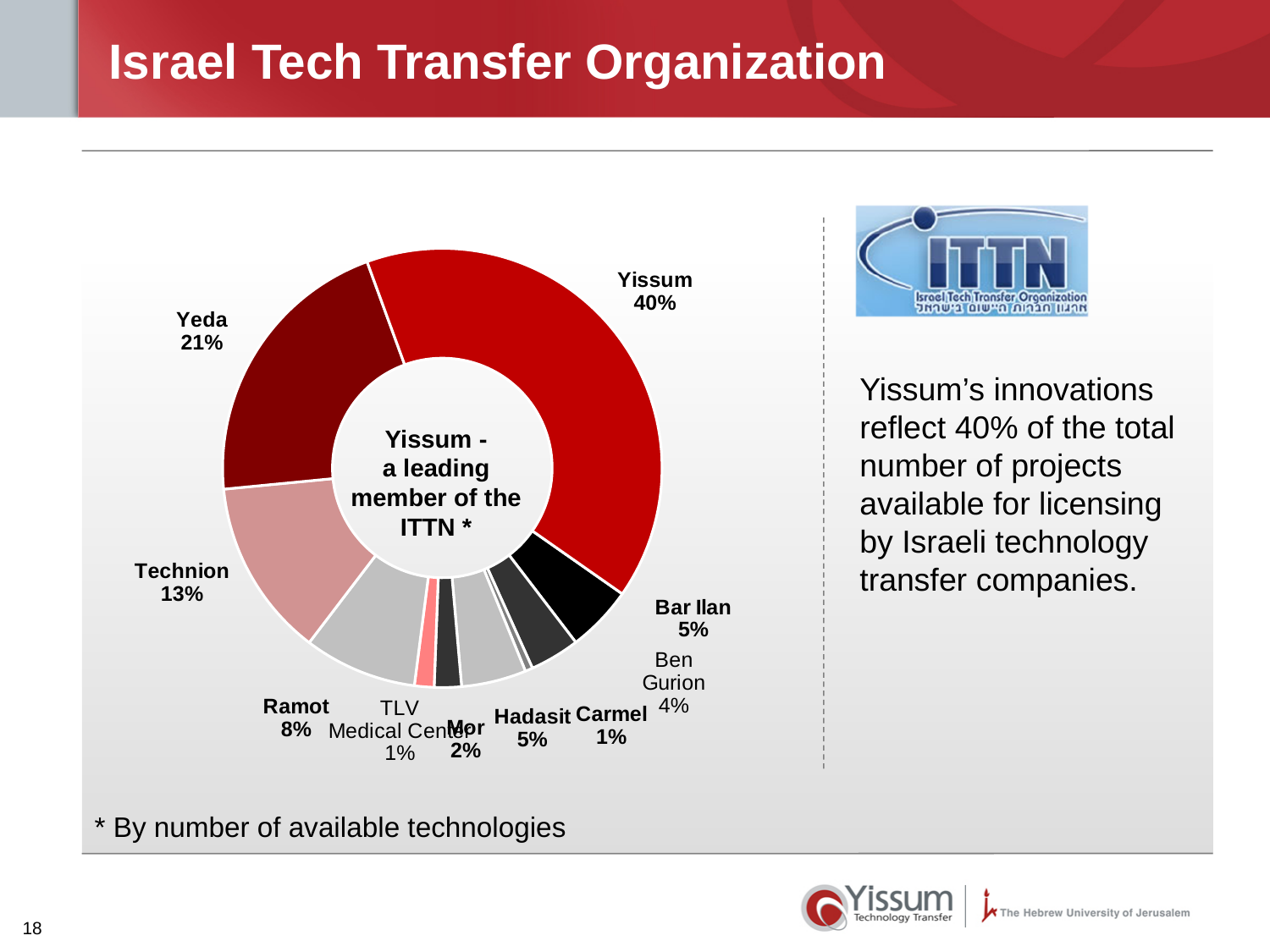
What is the difference in percentage points between Yissum and Yeda? 19 What percentage is shown for Mor? 2% What percentage is shown for Yeda? 21% What share of the donut chart does Yissum hold? 40% How many organizations are shown as slices in the chart? 10 What percentage is shown for Technion? 13% Which has a larger share, Technion or Ramot? Technion What text appears in the center of the donut chart? Yissum - a leading member of the ITTN * What is the combined share of Bar Ilan and Hadasit? 10% What percentage is shown for Ben Gurion? 4% What type of chart is shown on the slide? Donut (pie) chart Which organization has the largest share in the chart? Yissum